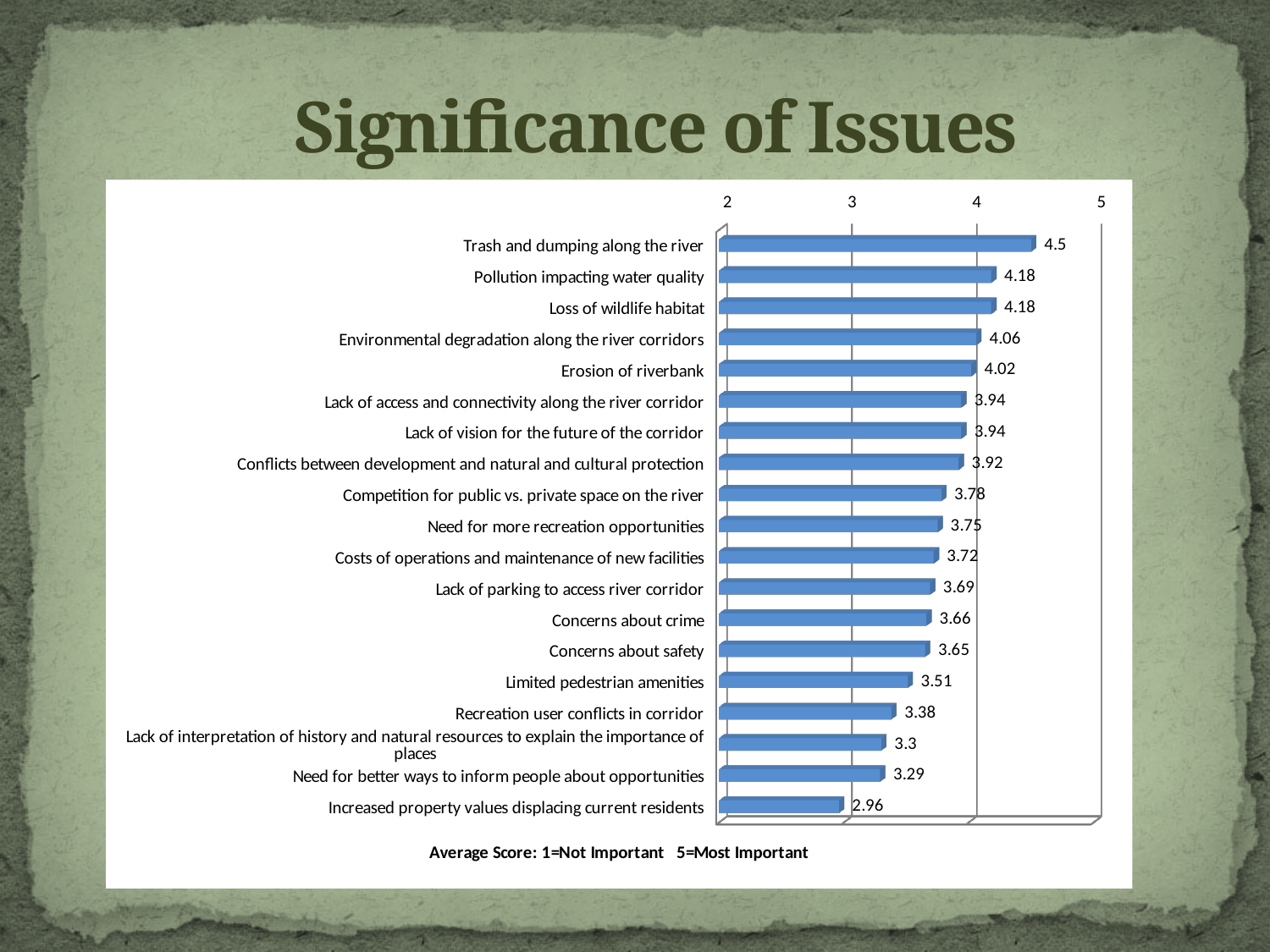
What is the average score for Trash and dumping along the river? 4.5 What is the title of the slide? Significance of Issues Is the value for Environmental degradation along the river corridors greater or less than 4? greater Which issue has the highest average score? Trash and dumping along the river What is the difference between the scores for Trash and dumping along the river and Increased property values displacing current residents? 1.54 What is the average score for Concerns about crime? 3.66 What is the average score for Erosion of riverbank? 4.02 Which issue has the lowest average score? Increased property values displacing current residents How many issues are plotted in the chart? 19 What is the average score for Increased property values displacing current residents? 2.96 Which has a higher average score, Limited pedestrian amenities or Recreation user conflicts in corridor? Limited pedestrian amenities What kind of chart is shown on the slide? Bar chart